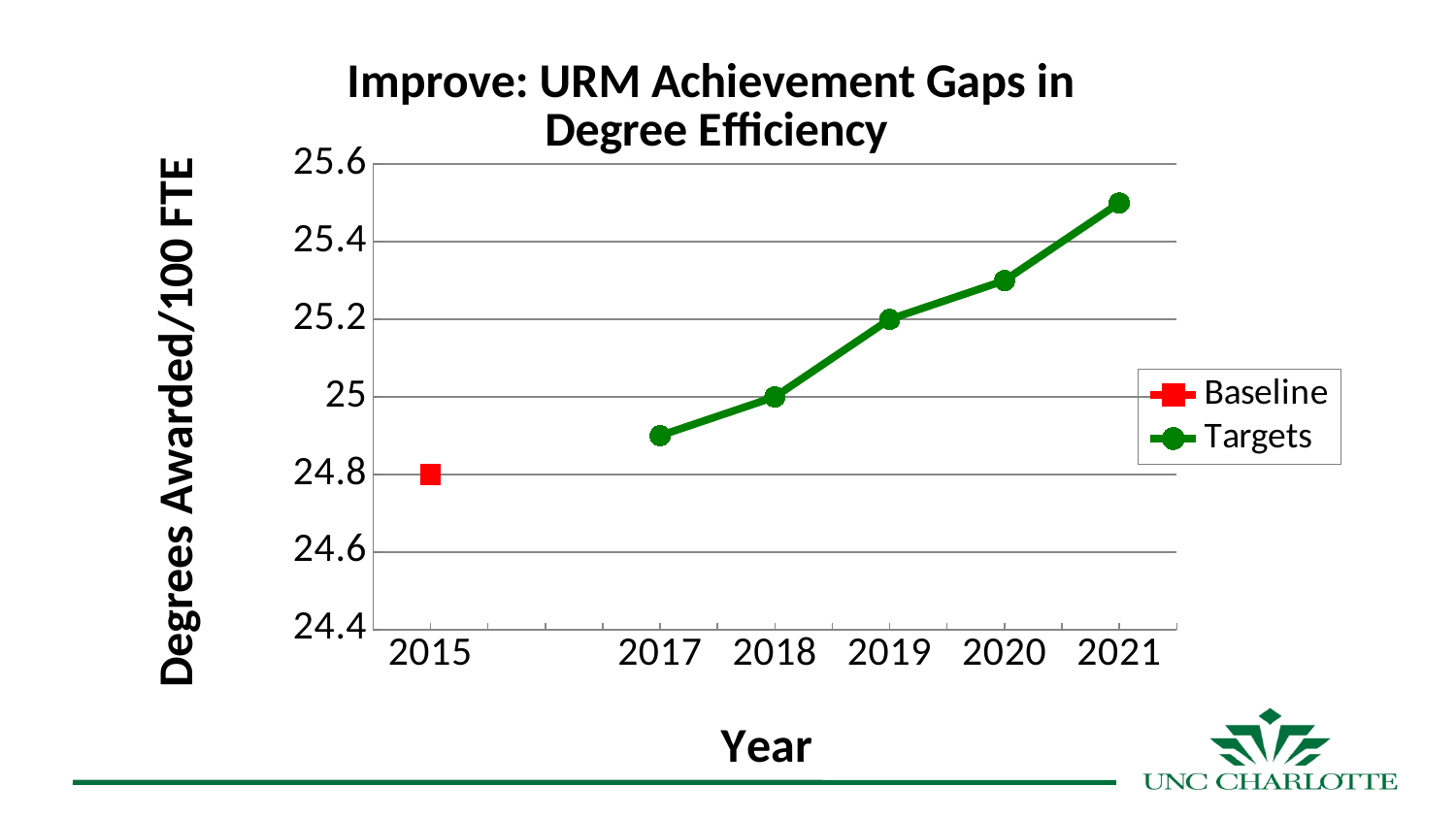
How many years are plotted for the Targets series? 5 What is the Targets value for 2018? 25 What kind of chart is shown on the slide? line chart How many series does the legend list? 2 Is the Targets value for 2020 greater or less than 25.2? greater Is the Targets value for 2021 greater or less than 25.4? greater What is the Baseline value for 2015? 24.8 Do the Targets values rise or fall from 2017 to 2021? rise Which year has the highest Targets value? 2021 Is the Targets value for 2017 greater or less than 25? less What is the title of the chart? Improve: URM Achievement Gaps in Degree Efficiency What is the Targets value for 2019? 25.2